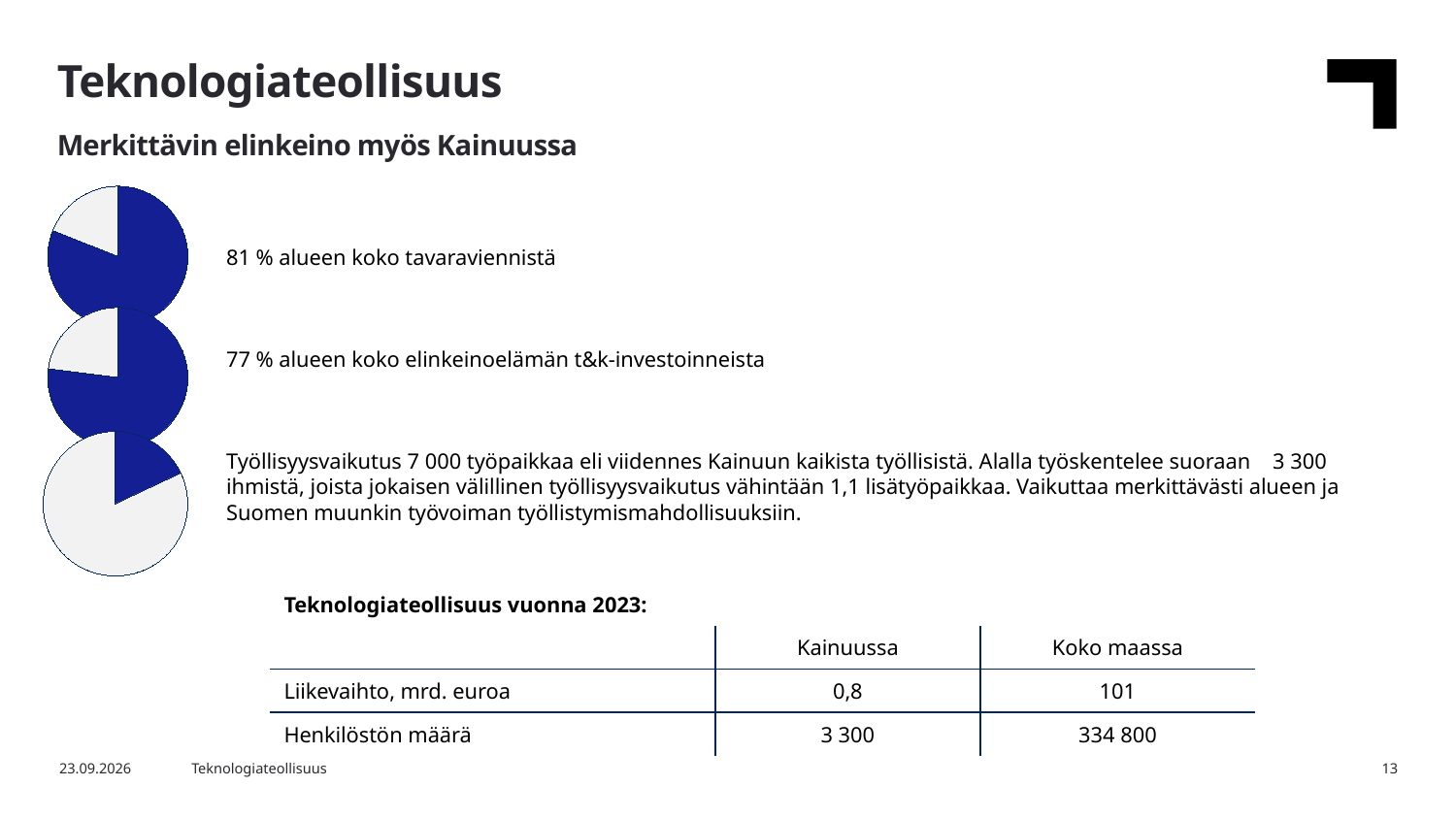
Which of the three pie charts has the largest blue slice? The top pie chart Which of the three pie charts has the smallest blue slice? The bottom pie chart In the middle pie chart (next to the text about t&k-investoinnit), what share does the blue slice represent? 77 % How many pie charts are on the slide? 3 What kind of charts are shown on the left side of the slide? Pie charts In the top pie chart (next to the text about tavaravienti), what share does the blue slice represent? 81 % What is the main title of the slide containing the pie charts? Teknologiateollisuus What is the difference between the blue shares of the top pie chart and the middle pie chart? 4 percentage points What colour is the larger slice in the middle pie chart? Blue In the bottom pie chart, which slice is larger, the blue one or the grey one? Grey In the top pie chart, which slice is larger, the blue one or the grey one? Blue How many slices does the top pie chart have? 2